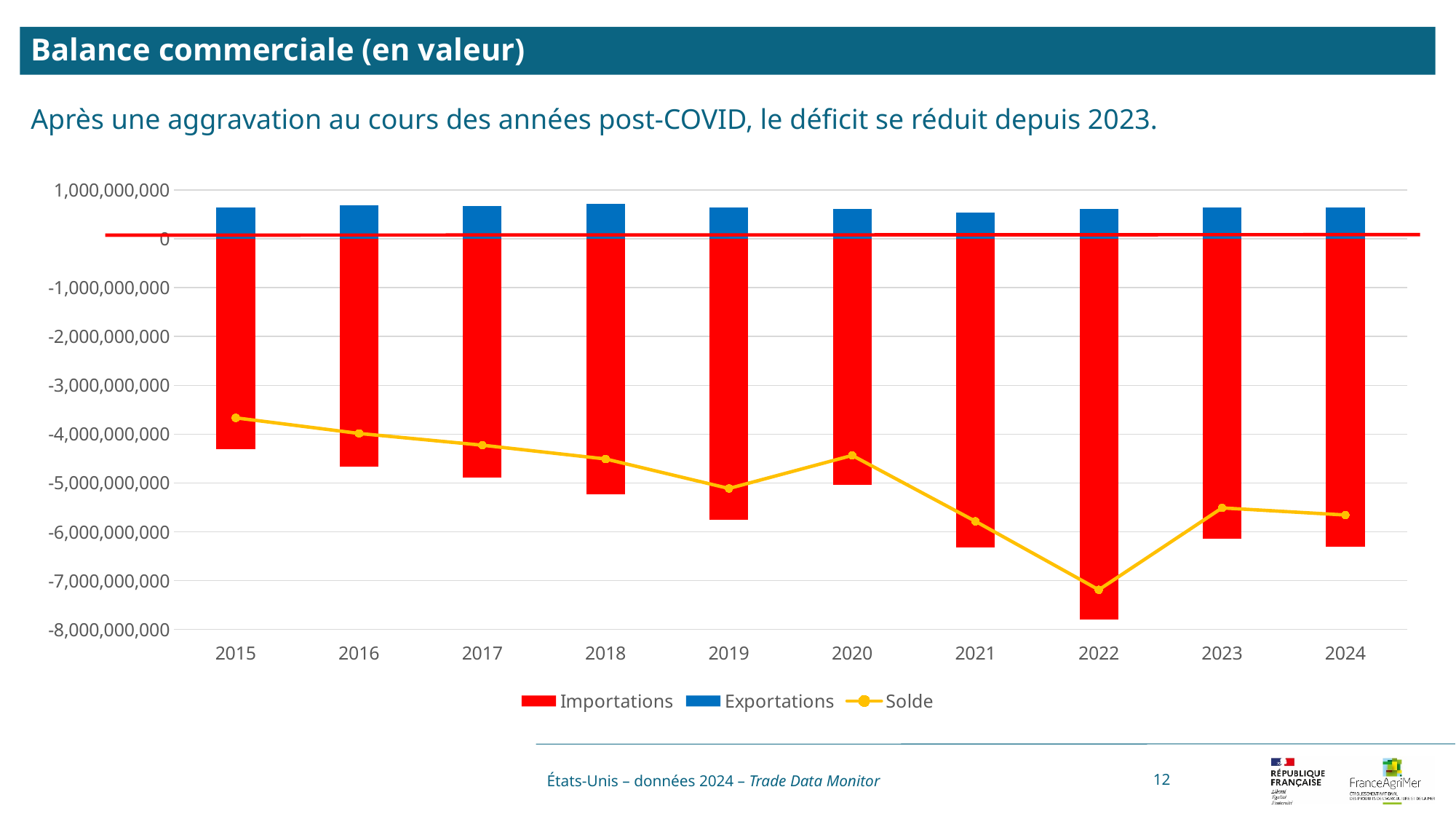
Does the Solde line rise or fall from 2022 to 2023? rise In which year does the Solde line reach its lowest point? 2022 How many series does the chart legend list? 3 Which series are listed in the chart legend? Importations, Exportations, Solde Which year has the larger Solde value, 2019 or 2020? 2020 Is the Importations value for 2022 greater or less than -7,000,000,000? less Is the Solde value for 2022 greater or less than -7,000,000,000? less How many years are shown on the x axis of the chart? 10 What kind of chart is shown on the slide? A combined bar and line chart Is the Solde value for 2015 greater or less than -4,000,000,000? greater In which year is the Solde line at its highest point? 2015 What is the title of the slide containing the chart? Balance commerciale (en valeur)